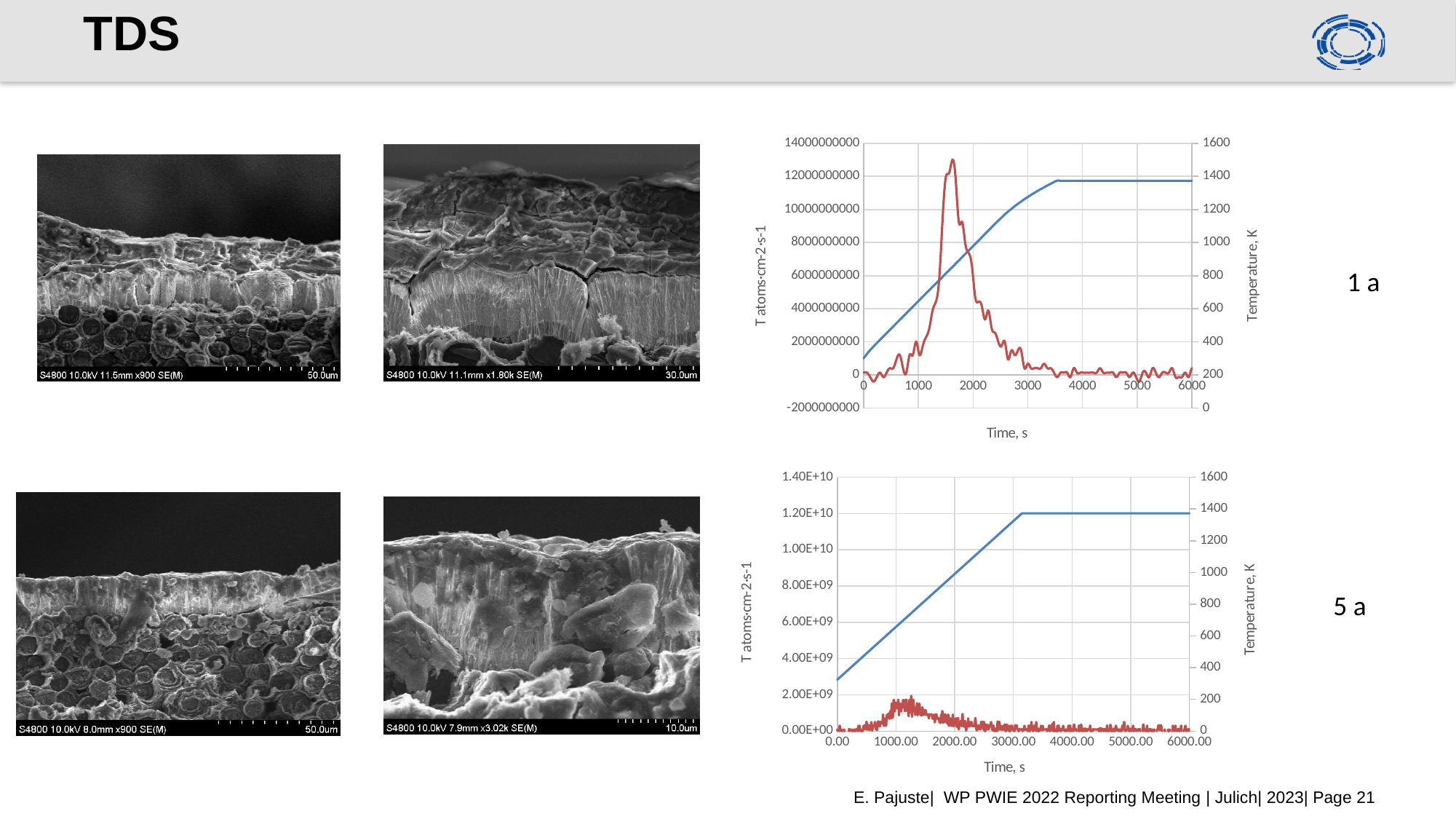
In the top chart (1 a), is the plateau value of the blue temperature line greater or less than 1200 K? greater In the top chart (1 a), is the plateau value of the blue temperature line greater or less than 1400 K? less What kind of chart is the bottom chart labelled 5 a? line chart In the top chart (1 a), does the blue temperature line rise or fall between 0 and 3000 s? rise In the top chart (1 a), is the peak value of the red line greater or less than 12000000000? greater What is the right-hand y-axis title of the top chart (1 a)? Temperature, K What kind of chart is the top chart labelled 1 a? line chart In the bottom chart (5 a), does the red line rise or fall between 1500 s and 3000 s? fall What is the x-axis title of the bottom chart (5 a)? Time, s